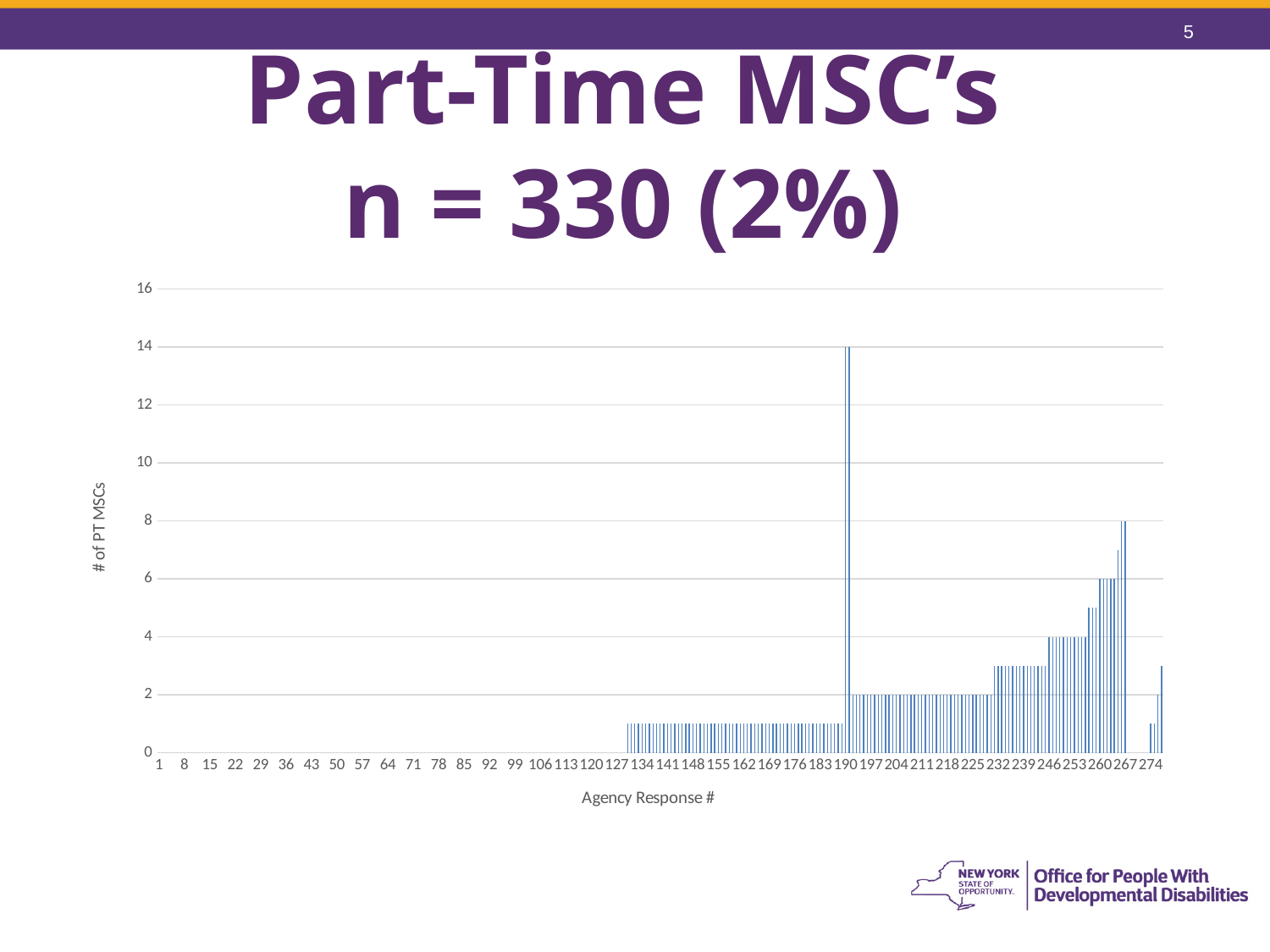
What is the first tick label shown on the horizontal axis? 1 What is the label of the horizontal axis? Agency Response # Is the value for agency response 50 greater or less than 4? less Do the bar values generally rise or fall from left to right along the x axis? rise What is the highest tick value shown on the vertical axis? 16 Is the value of the tallest bar greater or less than 12? greater What is the label of the vertical axis? # of PT MSCs What kind of chart is shown on the slide? bar chart What is the value of the tallest bar in the chart? 14 What is the last tick label shown on the horizontal axis? 274 Is the value for agency response 8 greater or less than 2? less